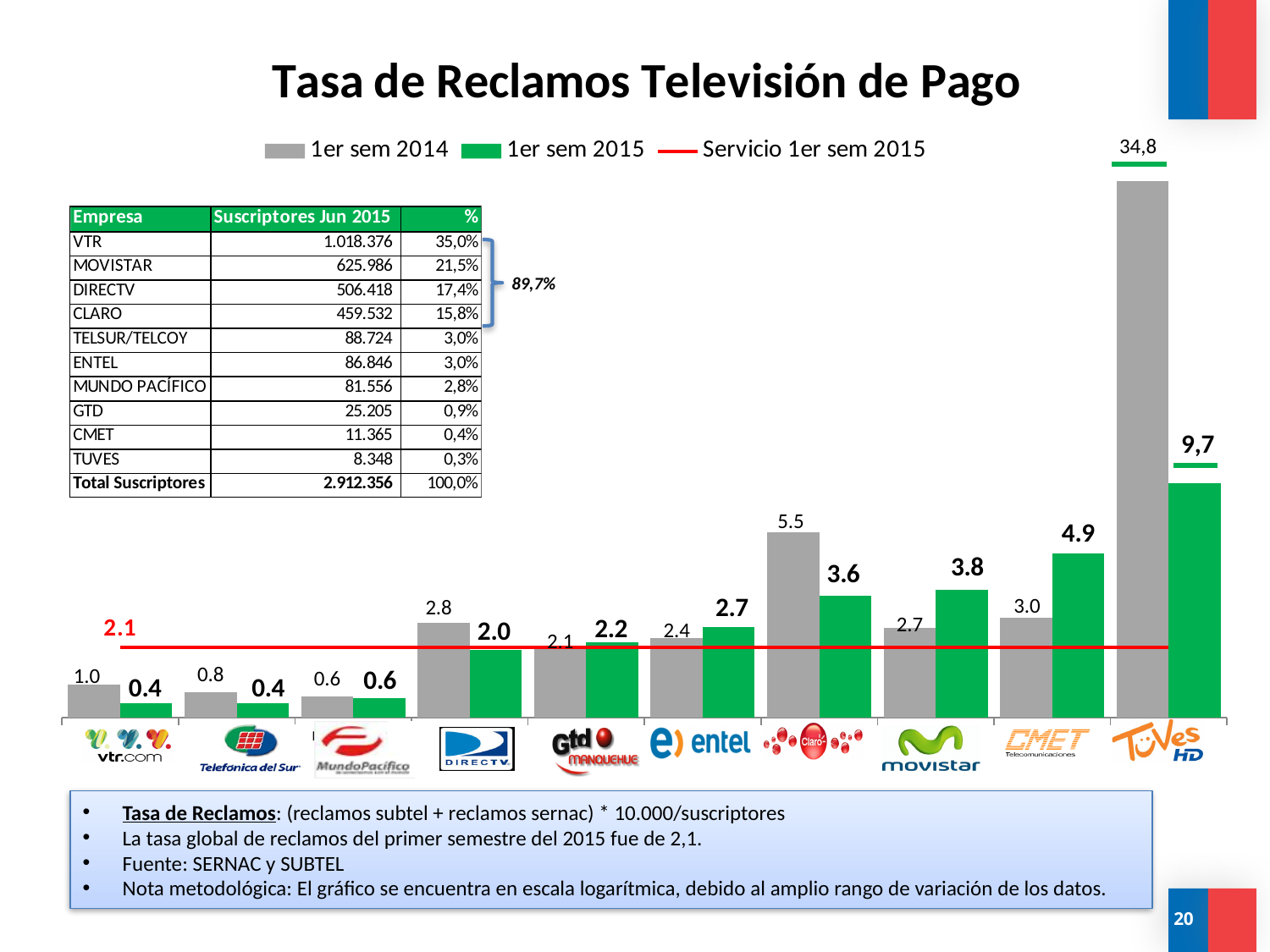
Which company has the lowest 1er sem 2014 value in the chart? Mundo Pacífico What is the 1er sem 2014 value for Claro in the chart? 5.5 For Movistar, which is larger: the 1er sem 2014 value or the 1er sem 2015 value? 1er sem 2015 What kind of chart is shown on the slide? bar chart What is the 1er sem 2015 value for CMET in the chart? 4.9 What is the 1er sem 2015 value for Tuves in the chart? 9,7 What value does the red 'Servicio 1er sem 2015' line mark in the chart? 2.1 Which company has the highest 1er sem 2014 value in the chart? Tuves How many companies (categories) are shown along the x axis of the chart? 10 How many series does the chart legend list? 3 What is the difference between the 1er sem 2014 and 1er sem 2015 values for DirecTV? 0.8 What is the title of the chart on the slide? Tasa de Reclamos Televisión de Pago